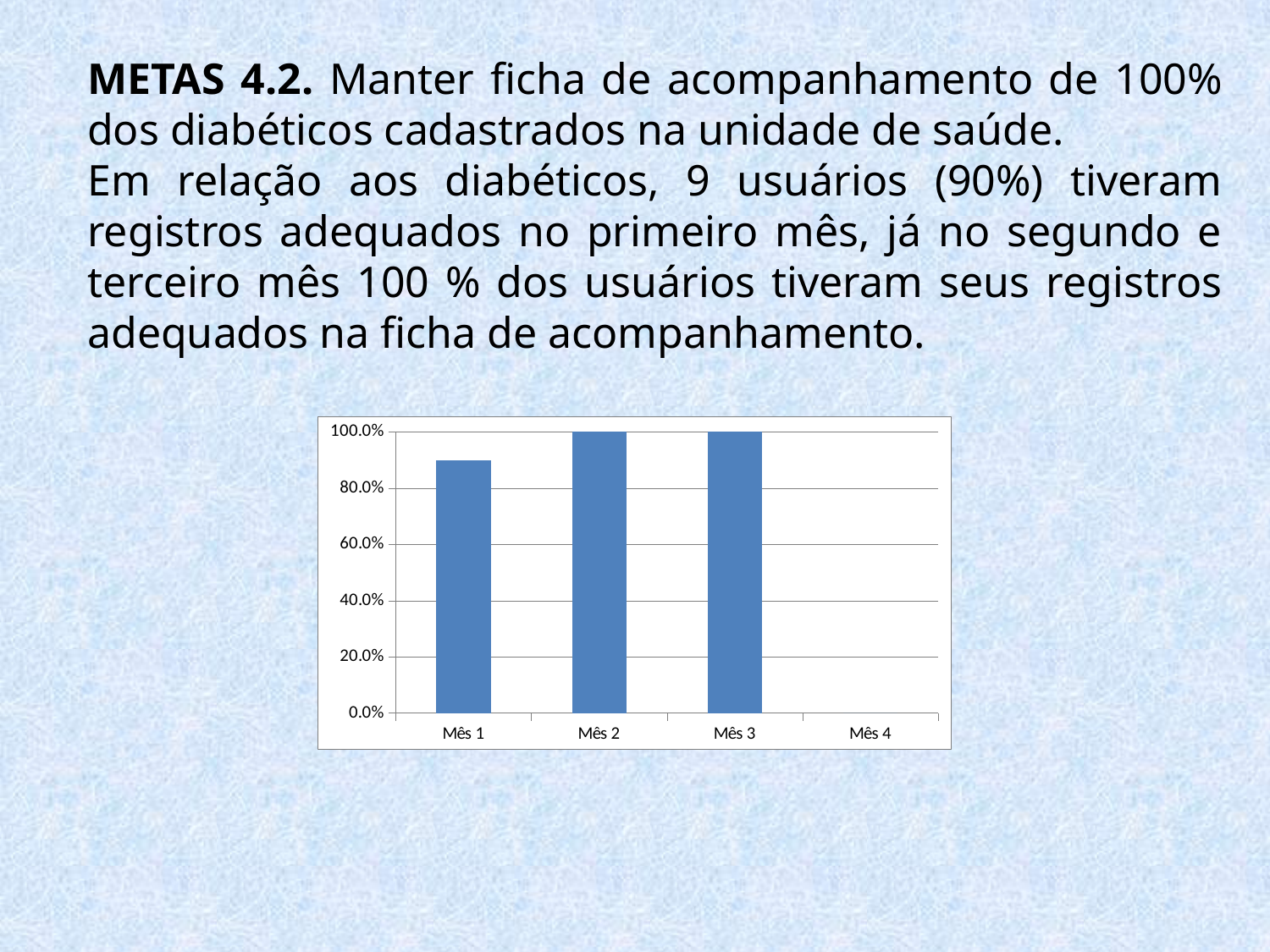
Is the value for Mês 1 greater or less than 80.0%? greater Does the value rise or fall from Mês 1 to Mês 2? rise How many categories are shown on the x axis of the chart? 4 What is the difference between the values for Mês 2 and Mês 3? 0.0% Which category on the x axis has no bar plotted? Mês 4 What kind of chart is shown on the slide? bar chart What is the value for Mês 2? 100.0% Among Mês 1, Mês 2 and Mês 3, which has the lowest value? Mês 1 Is the value for Mês 1 greater or less than 100.0%? less Which months reach 100.0% in the chart? Mês 2 and Mês 3 What is the value for Mês 3? 100.0% Which is larger, the value for Mês 1 or the value for Mês 2? Mês 2